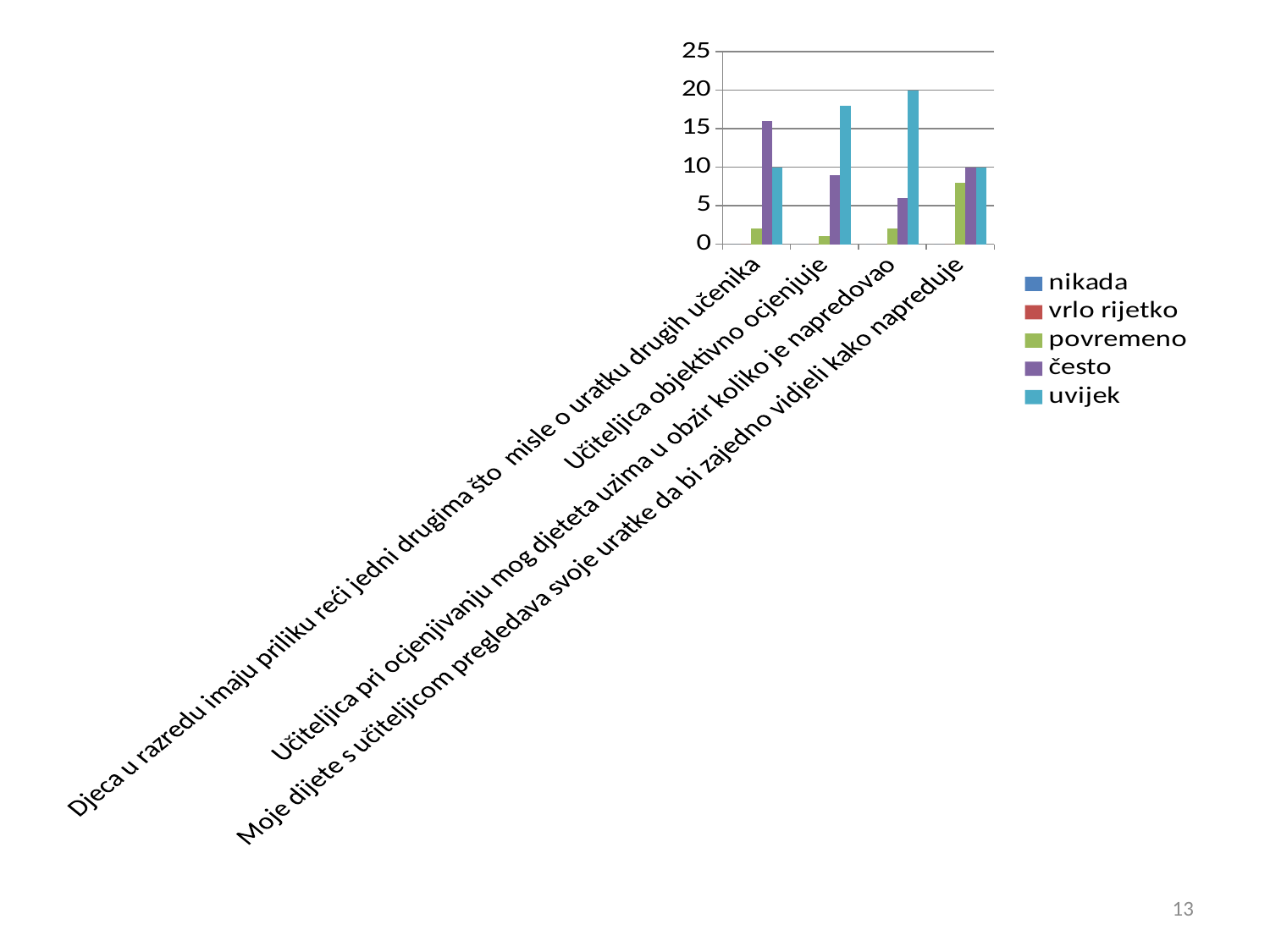
Is the value for 'često' in the category 'Djeca u razredu imaju priliku reći jedni drugima što misle o uratku drugih učenika' greater or less than 15? greater Is the value for 'povremeno' in the category 'Moje dijete s učiteljicom pregledava svoje uratke da bi zajedno vidjeli kako napreduje' greater or less than 5? greater Is the value for 'uvijek' in the category 'Učiteljica objektivno ocjenjuje' greater or less than 15? greater In the category 'Učiteljica objektivno ocjenjuje', which series has the larger value, 'često' or 'uvijek'? uvijek Which category has the highest value for the series 'često'? Djeca u razredu imaju priliku reći jedni drugima što misle o uratku drugih učenika Which category has the highest value for the series 'uvijek'? Učiteljica pri ocjenjivanju mog djeteta uzima u obzir koliko je napredovao How many categories are shown on the x axis? 4 How many series does the legend list? 5 Which legend entry is shown in purple? često What kind of chart is shown on the slide? bar chart In the category 'Djeca u razredu imaju priliku reći jedni drugima što misle o uratku drugih učenika', which series has the larger value, 'često' or 'uvijek'? često